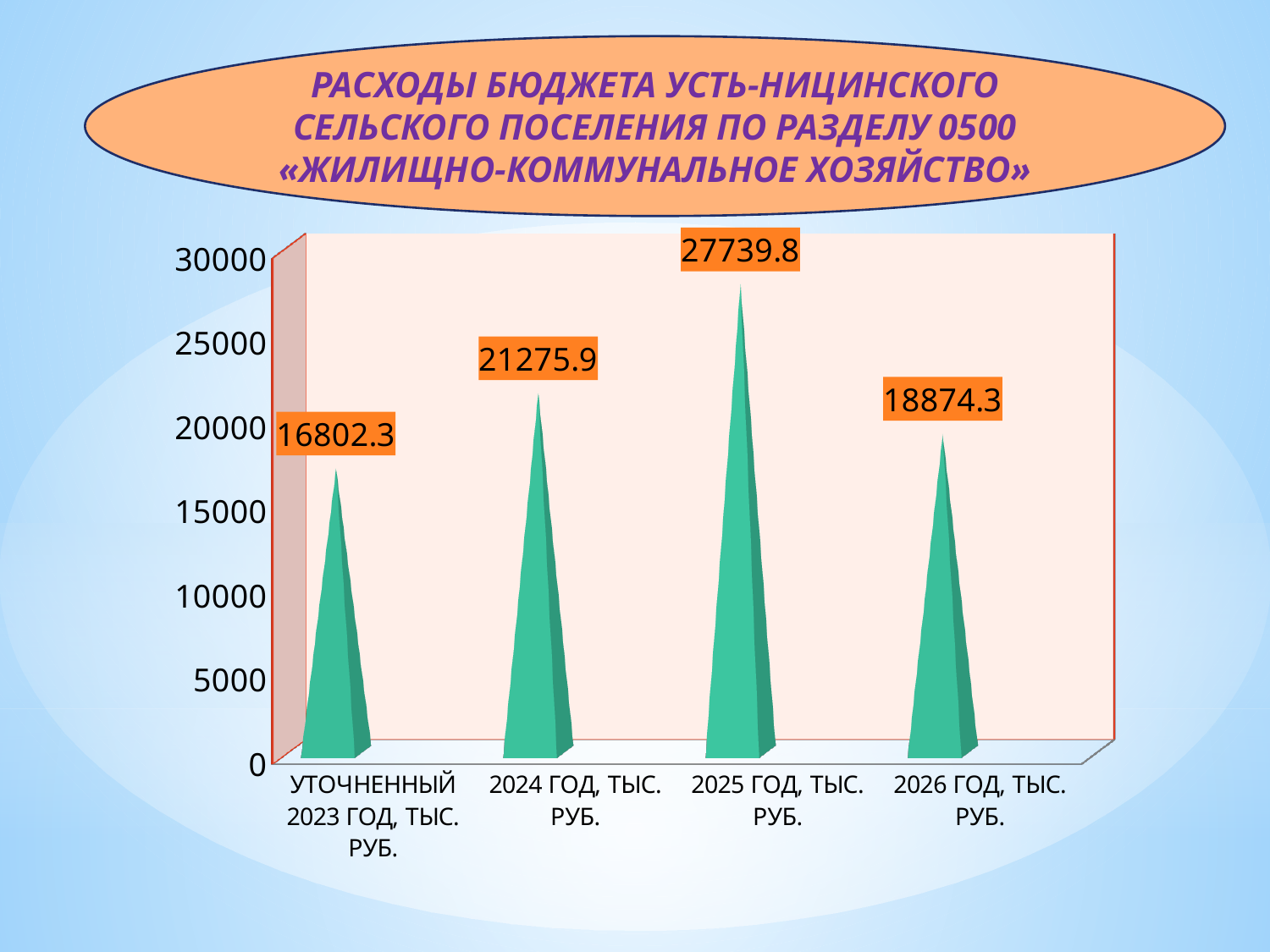
What is the value for 2024 год, тыс. руб.? 21275.9 What is the difference between the values for 2025 год and 2024 год? 6463.9 What is the difference between the values for 2026 год and Уточненный 2023 год? 2072.0 What is the value for 2026 год, тыс. руб.? 18874.3 Do the values rise or fall from Уточненный 2023 год to 2025 год? rise Is the value for 2025 год greater or less than 25000? greater What is the value for Уточненный 2023 год, тыс. руб.? 16802.3 Which is larger, the value for 2024 год or the value for 2026 год? 2024 год, тыс. руб. How many categories are shown on the x axis? 4 What kind of chart is shown on the slide? bar chart Which category has the lowest value? Уточненный 2023 год, тыс. руб. Which category has the highest value? 2025 год, тыс. руб.